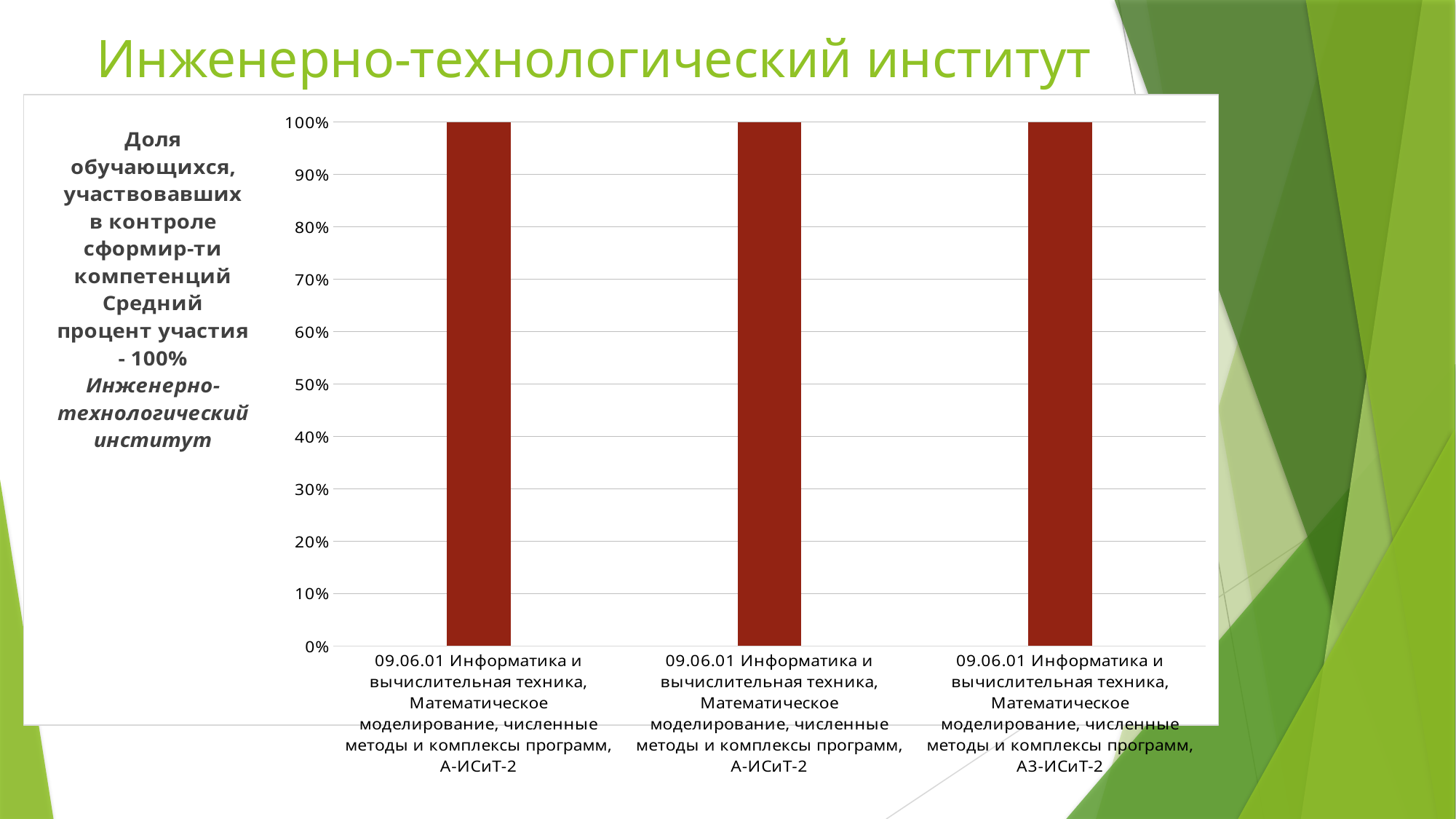
What is the highest value shown on the vertical axis? 100% What kind of chart is shown on the slide? bar chart Do the bar values rise, fall, or stay the same from left to right? stay the same How many bars are plotted in the chart? 3 Is the value for the АЗ-ИСиТ-2 bar greater or less than 90%? greater What is the value of the middle bar (А-ИСиТ-2)? 100% What is the difference between the value for АЗ-ИСиТ-2 and the value for the leftmost А-ИСиТ-2 bar? 0% What is the value of the first bar (А-ИСиТ-2, leftmost)? 100% Which programme code appears in every category label on the x axis? 09.06.01 What colour are the bars in the chart? dark red What is the value of the bar for group АЗ-ИСиТ-2? 100% Is the value for the leftmost bar greater or less than 50%? greater